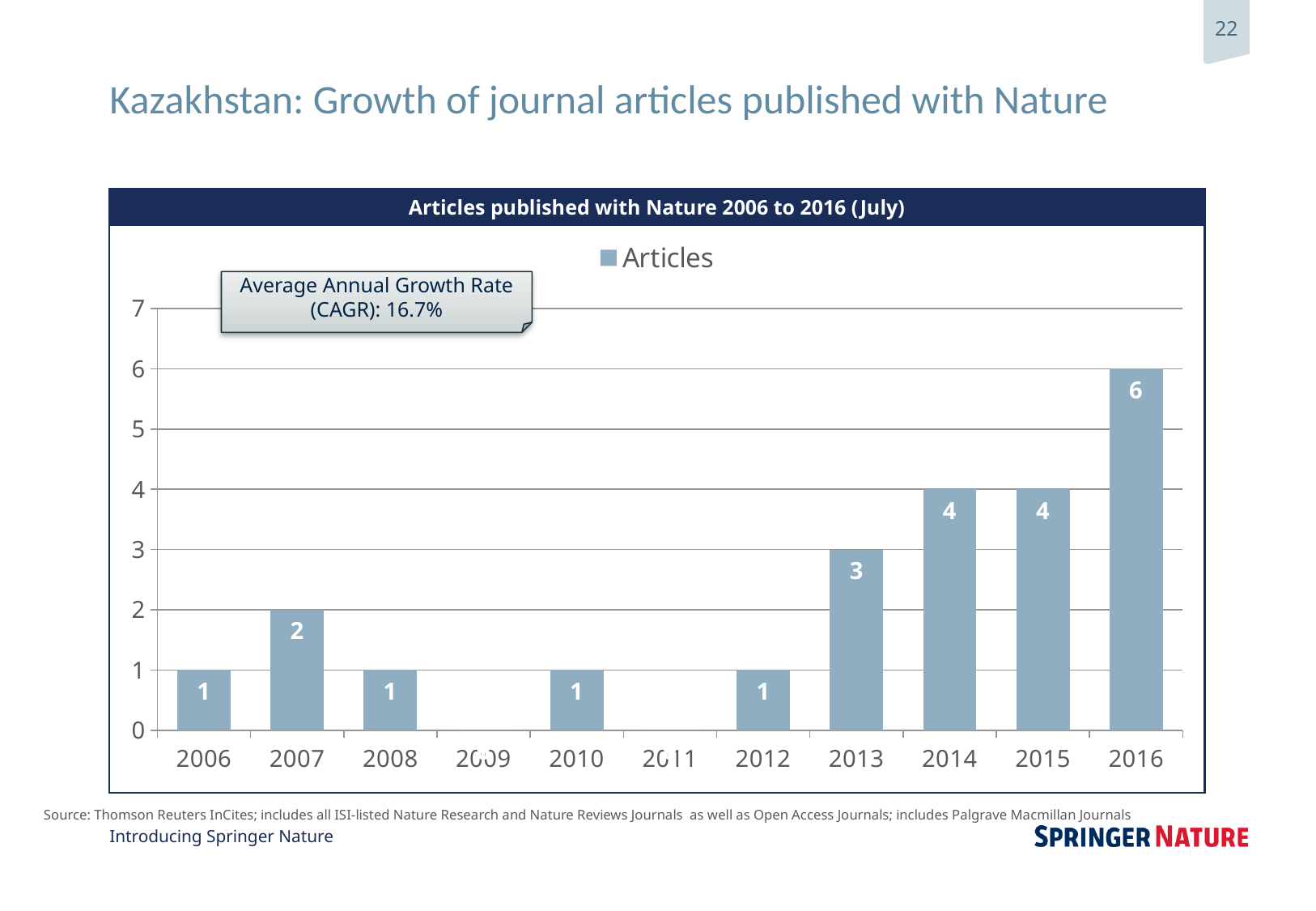
How many years are shown on the x axis? 11 What is the value for 2016? 6 What is the value for 2013? 3 What is the value for 2007? 2 Which year has the highest number of articles? 2016 How many series does the legend list? 1 Which is larger, the value for 2013 or the value for 2007? 2013 What kind of chart is shown? bar chart What is the difference between the values for 2014 and 2007? 2 Is the value for 2016 greater or less than 5? greater What is the difference between the values for 2016 and 2013? 3 What is the Average Annual Growth Rate (CAGR) shown in the callout on the chart? 16.7%